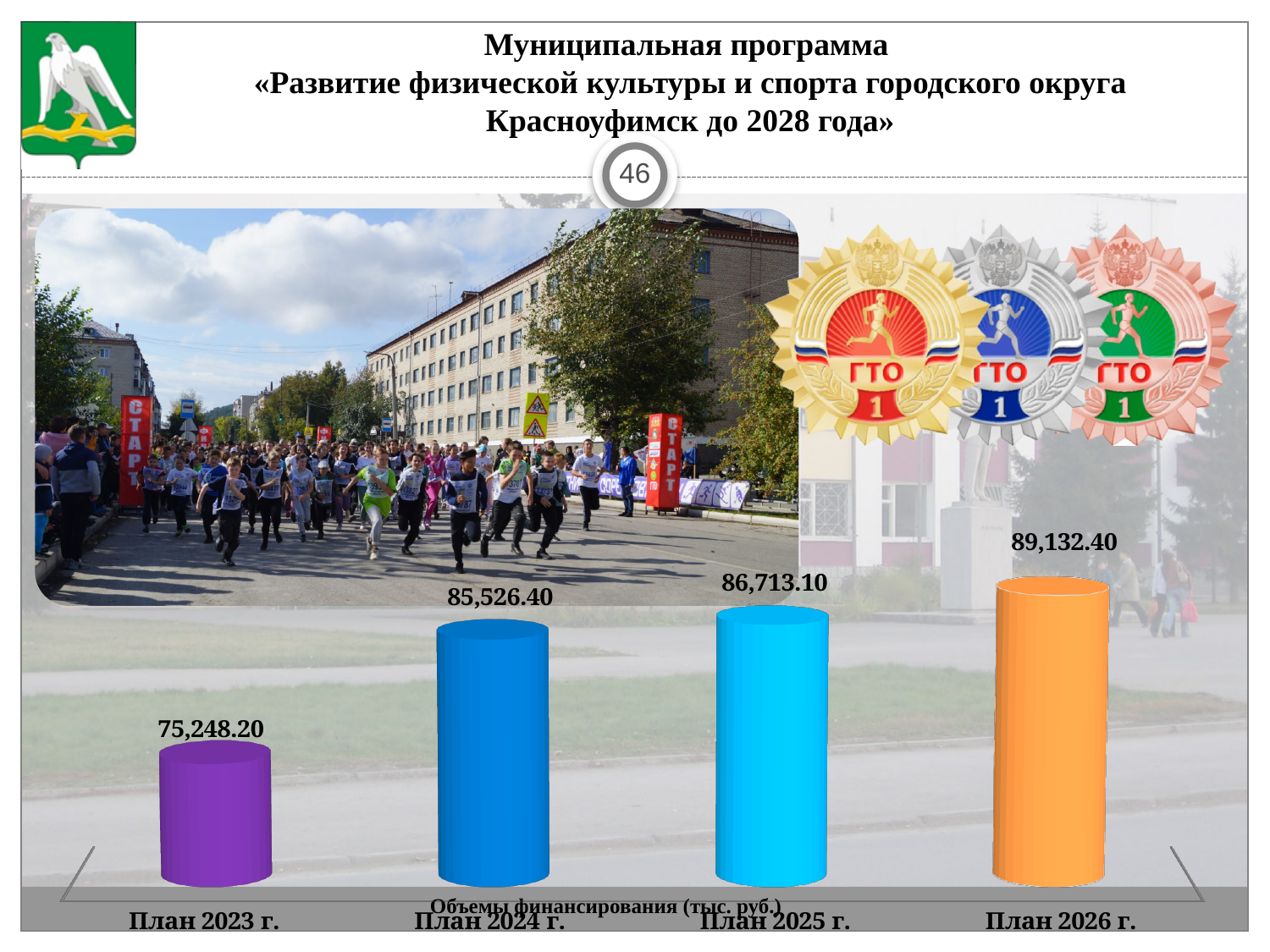
Do the values rise or fall from План 2023 г. to План 2026 г.? Rise Which category has the lowest value? План 2023 г. What is the value for План 2026 г.? 89,132.40 What is the value for План 2025 г.? 86,713.10 What is the value for План 2023 г.? 75,248.20 What is the value for План 2024 г.? 85,526.40 Which is larger, the value for План 2024 г. or the value for План 2023 г.? План 2024 г. How many categories are shown in the chart? 4 What kind of chart is shown on the slide? Bar chart Which category has the highest value? План 2026 г. What is the difference between the values for План 2024 г. and План 2023 г.? 10,278.20 What is the difference between the values for План 2026 г. and План 2023 г.? 13,884.20